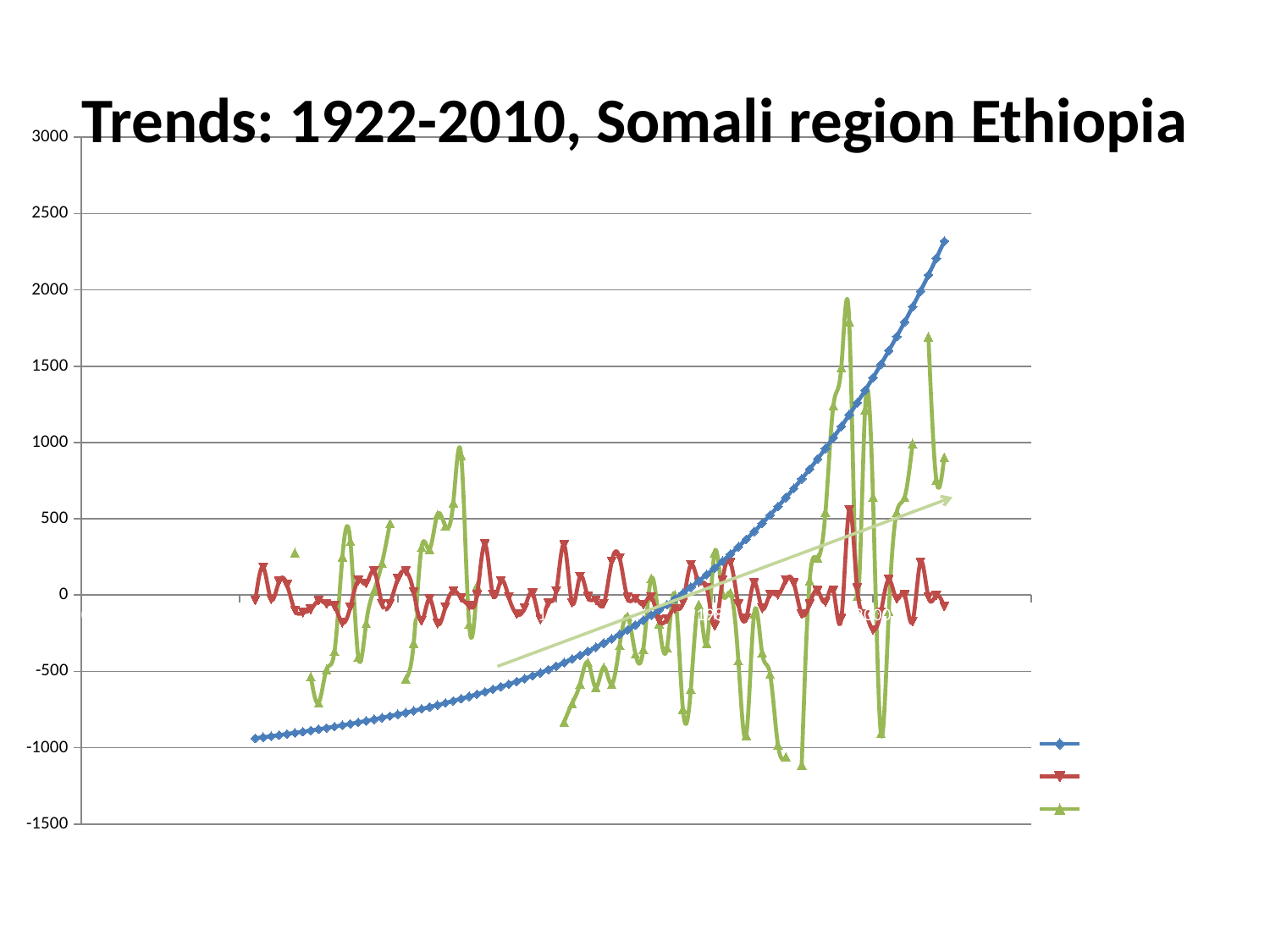
Is the highest peak of the red triangle series greater or less than 250? greater What is the title of the chart? Trends: 1922-2010, Somali region Ethiopia How many series does the legend list? 3 Is the first value of the blue diamond series greater or less than -500? less What kind of chart is shown on the slide? line chart Which series reaches the lowest value on the chart: the blue diamond series or the green triangle series? green triangle series Does the blue diamond series rise or fall from left to right along the x axis? rise Is the lowest point of the green triangle series greater or less than -1000? less Which series reaches the highest value on the chart: the blue diamond series or the green triangle series? blue diamond series What is the highest value shown on the vertical axis? 3000